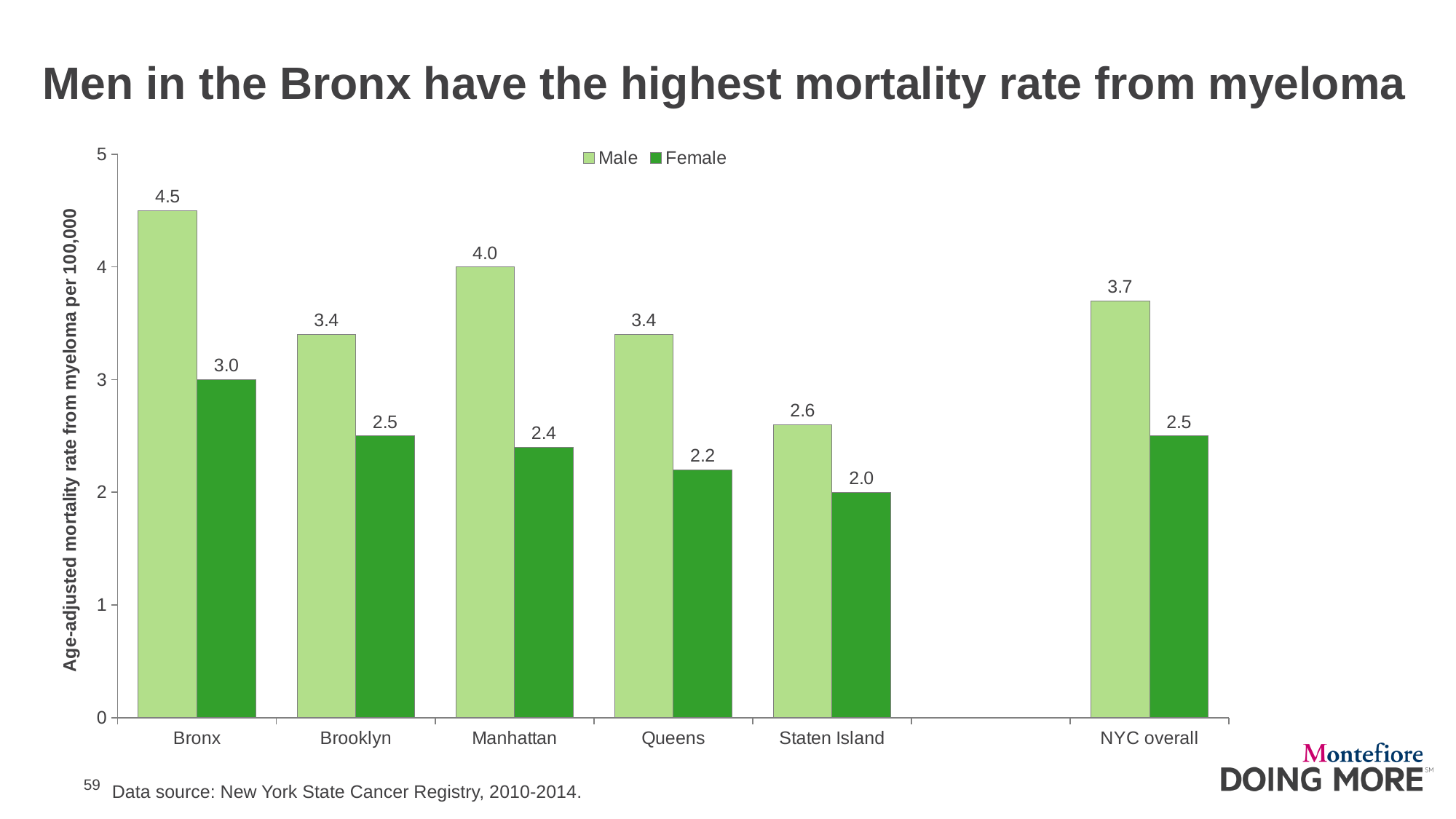
What is the label of the y axis? Age-adjusted mortality rate from myeloma per 100,000 Which is larger, the male mortality rate in Brooklyn or the male mortality rate in Staten Island? Brooklyn What is the female mortality rate from myeloma in Queens? 2.2 Which borough has the highest male mortality rate from myeloma? Bronx How many categories are shown on the x axis? 6 What is the female mortality rate from myeloma for NYC overall? 2.5 What kind of chart is shown on the slide? Bar chart Which borough has the lowest female mortality rate from myeloma? Staten Island Is the male mortality rate for NYC overall greater or less than 4? less How many series does the legend list? 2 What is the difference between the male and female mortality rates in Manhattan? 1.6 What is the male mortality rate from myeloma in the Bronx? 4.5